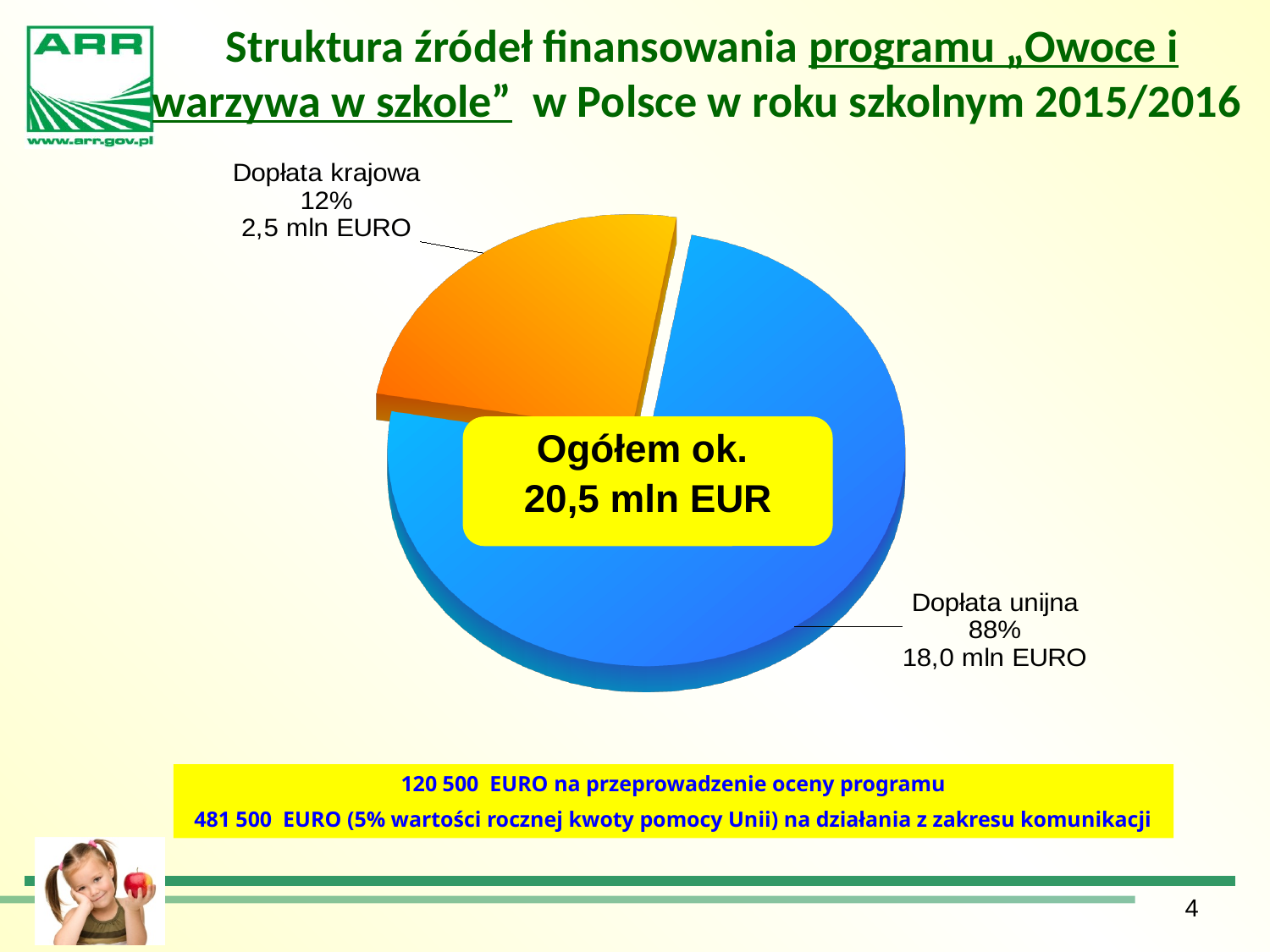
What colour is the "Dopłata krajowa" slice? orange What kind of chart is shown on the slide? pie chart How many slices does the pie chart have? 2 What percentage share does the "Dopłata unijna" slice have? 88% What percentage share does the "Dopłata krajowa" slice have? 12% What is the difference in percentage points between the "Dopłata unijna" and "Dopłata krajowa" shares? 76 percentage points Which slice of the pie is the largest? Dopłata unijna What is the value shown for "Dopłata unijna"? 18,0 mln EURO Which is larger, "Dopłata unijna" or "Dopłata krajowa"? Dopłata unijna What is the value shown for "Dopłata krajowa"? 2,5 mln EURO Which slice of the pie is the smallest? Dopłata krajowa What total amount is shown in the label in the centre of the pie chart? Ogółem ok. 20,5 mln EUR